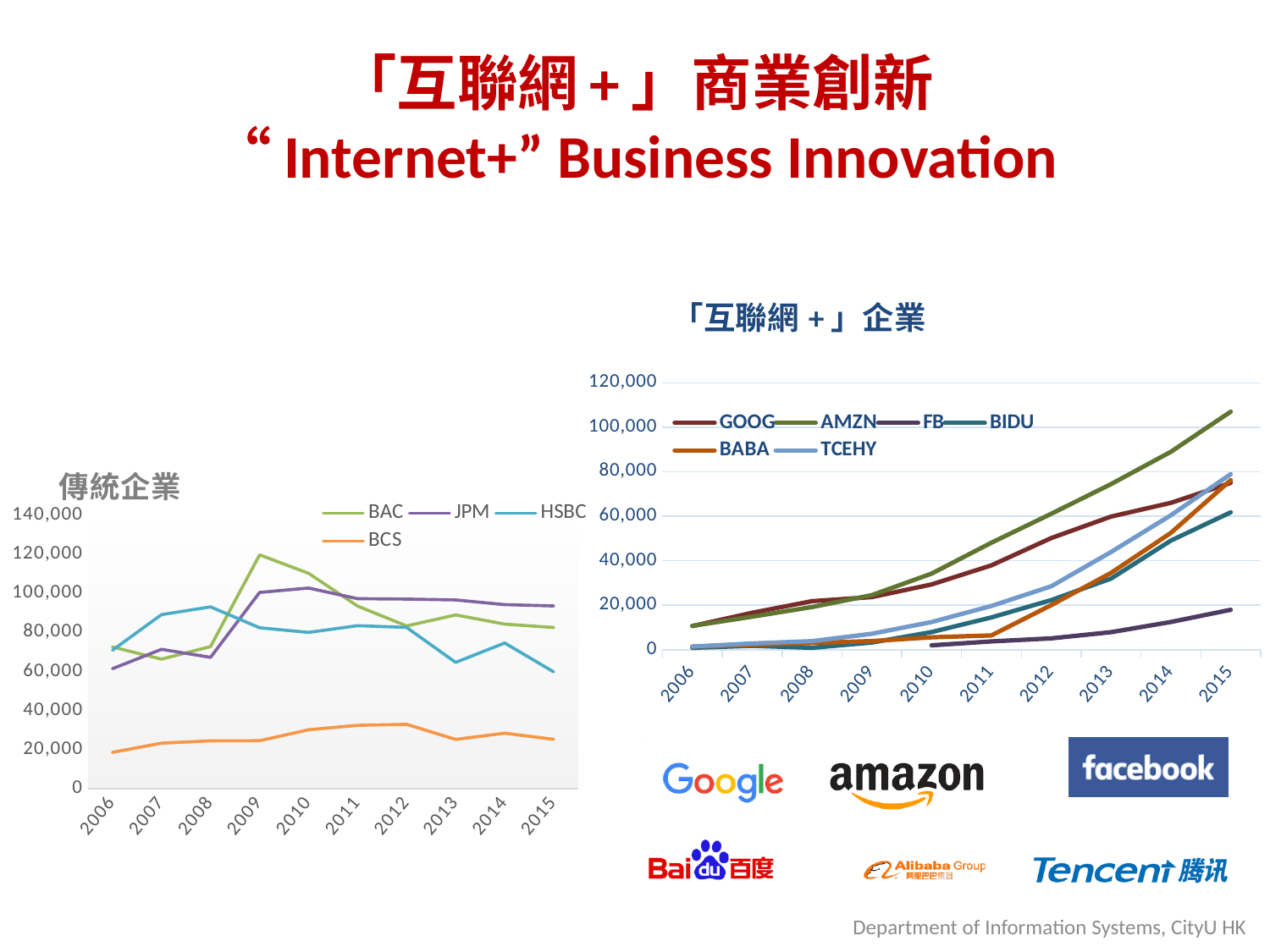
In the 傳統企業 chart on the left, is the value for BCS in 2015 greater or less than 40,000? less What kind of chart is the 傳統企業 chart on the left? line chart In the 「互聯網+」企業 chart on the right, is the value for AMZN in 2015 greater or less than 100,000? greater In the 「互聯網+」企業 chart on the right, which series has the lowest value in 2015? FB How many years are shown on the x axis of the 「互聯網+」企業 chart on the right? 10 How many series does the legend of the 「互聯網+」企業 chart on the right list? 6 In the 「互聯網+」企業 chart on the right, does the AMZN line rise or fall from 2006 to 2015? rise In the 傳統企業 chart on the left, is the value for BAC in 2009 greater or less than 100,000? greater In the 傳統企業 chart on the left, which series has the lowest values across all years? BCS How many series does the legend of the 傳統企業 chart on the left list? 4 In the 「互聯網+」企業 chart on the right, which is larger in 2015, GOOG or BIDU? GOOG In the 「互聯網+」企業 chart on the right, which series has the highest value in 2015? AMZN